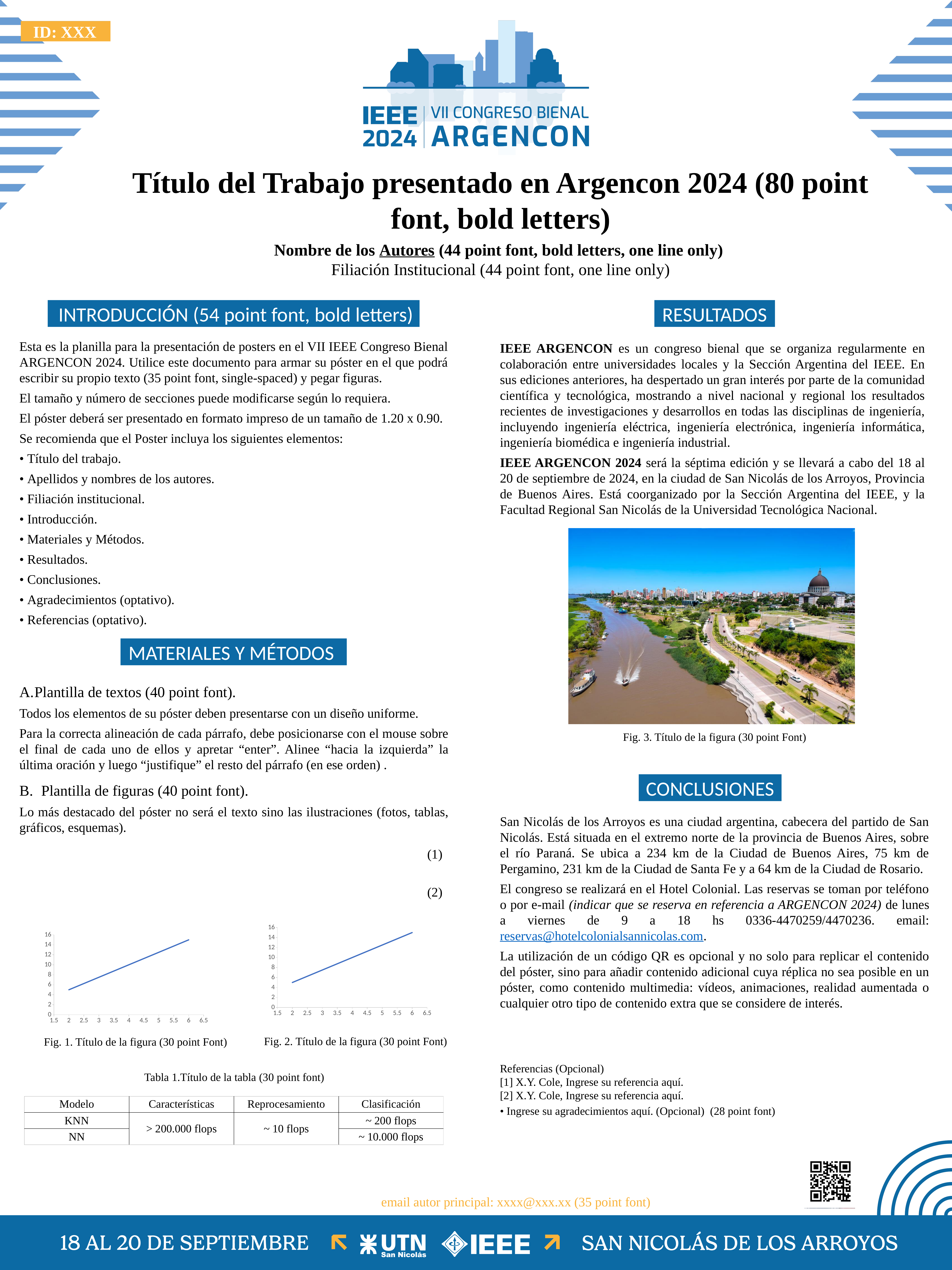
What kind of chart is Fig. 2? line chart How many lines are plotted in Fig. 1? 1 In Fig. 2, is the value at x = 6 greater or less than 12? greater What kind of chart is Fig. 1? line chart In Fig. 1, do the values rise or fall as x increases? rise What is the highest tick value shown on the y axis of Fig. 2? 16 In Fig. 2, is the value at x = 2 greater or less than 8? less In Fig. 1, is the value at x = 2 greater or less than 8? less In Fig. 1, which is larger, the value at x = 2 or the value at x = 6? x = 6 In Fig. 2, do the values rise or fall as x increases? rise In Fig. 2, which is larger, the value at x = 2 or the value at x = 6? x = 6